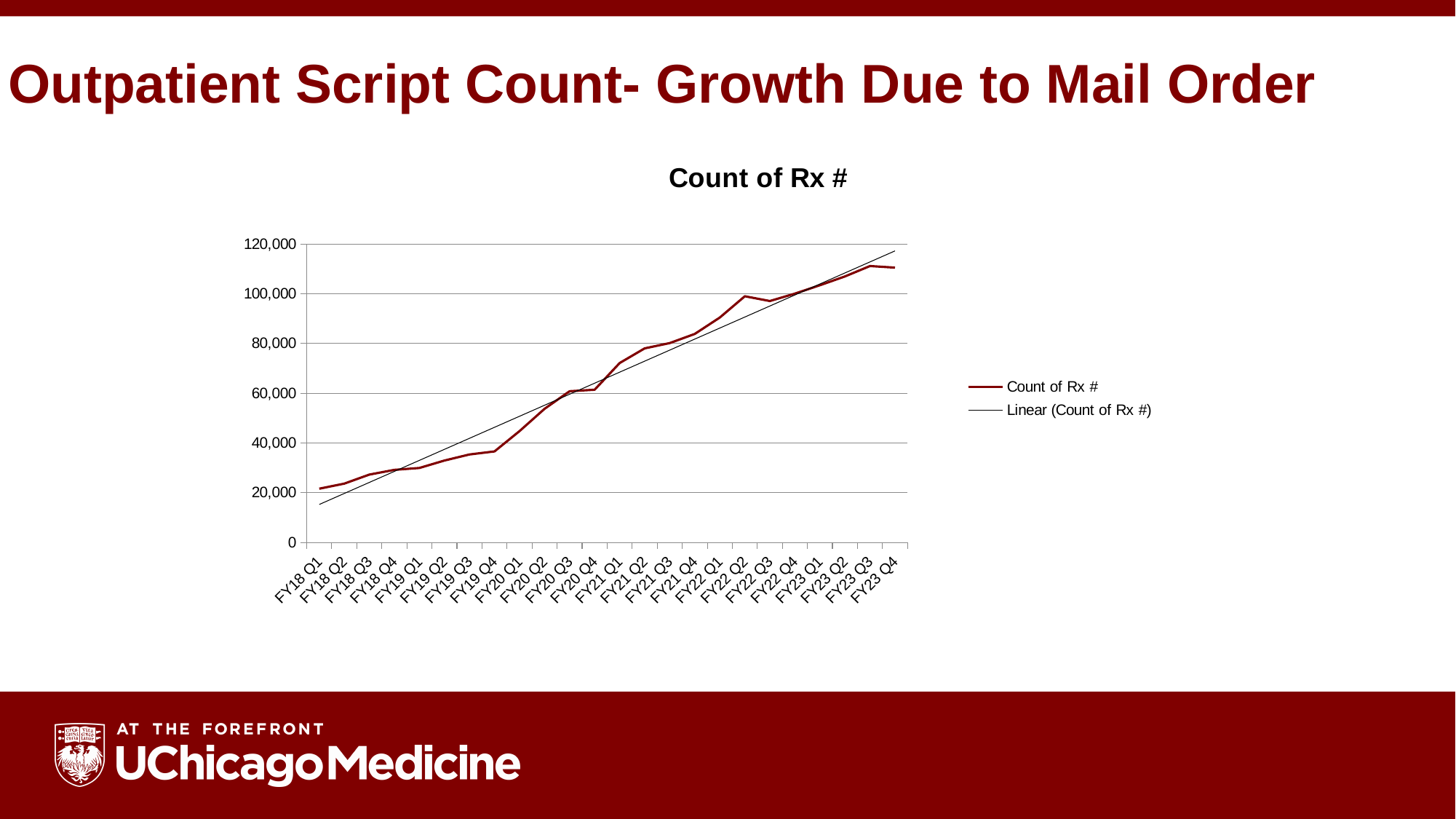
How many quarters are plotted along the x axis? 24 What is the title of the chart? Count of Rx # How many series does the legend list? 2 What is the second entry listed in the legend? Linear (Count of Rx #) Which is larger, the Count of Rx # for FY20 Q1 or for FY21 Q1? FY21 Q1 What kind of chart is shown on the slide? line chart Do the Count of Rx # values generally rise or fall from FY18 Q1 to FY23 Q4? rise Is the Count of Rx # for FY23 Q3 greater or less than 100,000? greater Which quarter has the lowest Count of Rx #? FY18 Q1 Is the Count of Rx # for FY18 Q1 greater or less than 40,000? less Is the Count of Rx # for FY21 Q4 greater or less than 80,000? greater